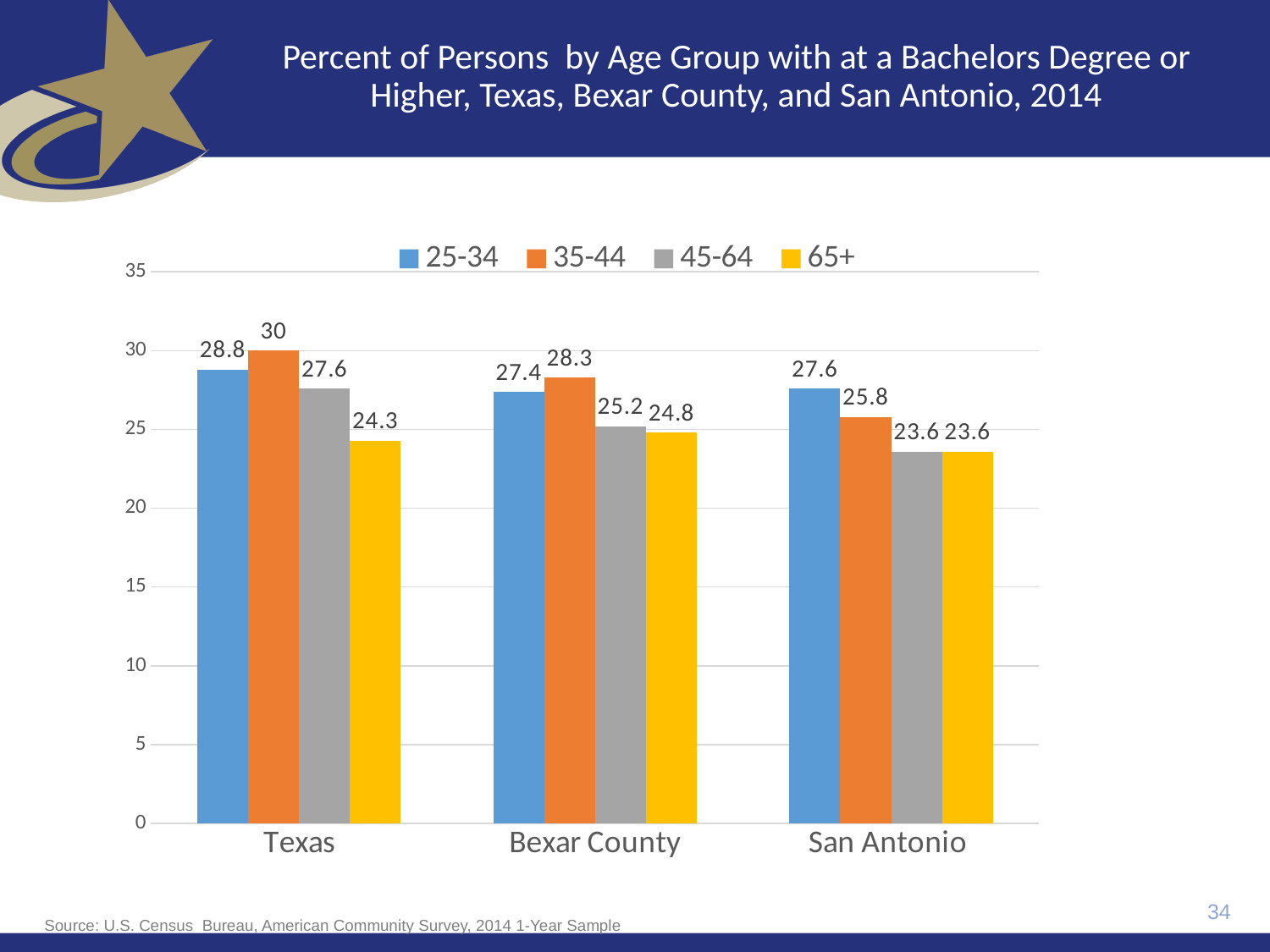
What is the value for the 65+ age group in Bexar County? 24.8 Which colour represents the 65+ age group in the legend? yellow Is the value for the 45-64 age group in San Antonio greater or less than 25? less What kind of chart is shown on the slide? bar chart What is the difference between the 35-44 and 65+ values in Texas? 5.7 What is the value for the 35-44 age group in Texas? 30 How many series does the legend list? 4 Which age group has the highest value in Bexar County? 35-44 What is the value for the 25-34 age group in San Antonio? 27.6 How many geographic categories are shown on the x axis? 3 Which is larger: the 25-34 value in Texas or the 25-34 value in Bexar County? Texas Which age group has the lowest value in Texas? 65+